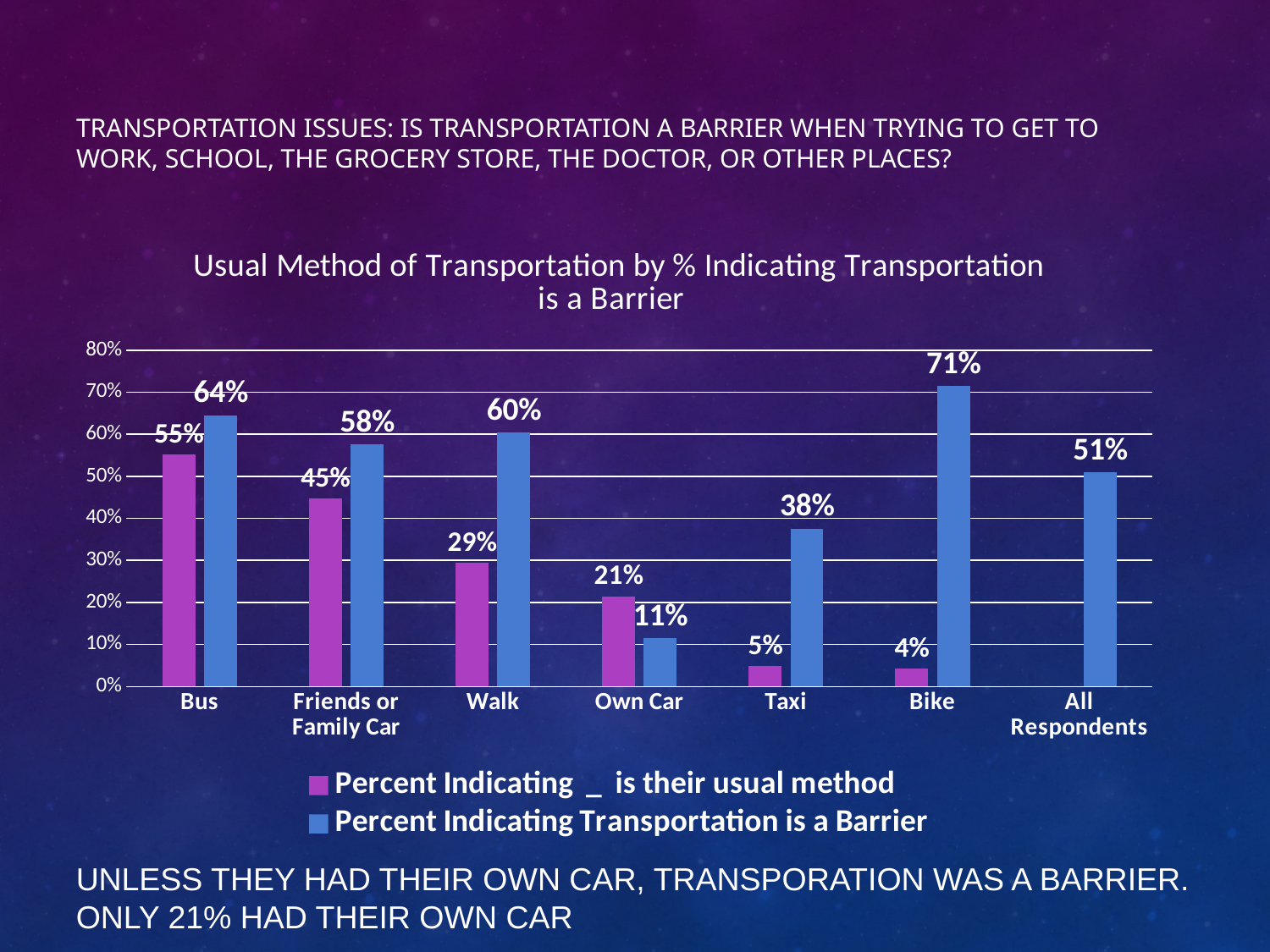
What percent of All Respondents indicated transportation is a barrier? 51% How many categories are shown on the x axis of the chart? 7 What percent of Own Car users indicated transportation is a barrier? 11% What kind of chart is shown on the slide? Bar chart How many series does the chart legend list? 2 Which is larger: the percent indicating Walk is their usual method, or the percent of Walk users indicating transportation is a barrier? Percent Indicating Transportation is a Barrier Which category has the highest percent indicating transportation is a barrier? Bike What percent of Bike users indicated transportation is a barrier? 71% What is the difference between the percent indicating transportation is a barrier for Bus and for Own Car? 53% What percent of respondents indicated Bus is their usual method of transportation? 55% What colour are the bars for the series 'Percent Indicating Transportation is a Barrier'? Blue Which category has the lowest percent indicating it is their usual method of transportation? Bike